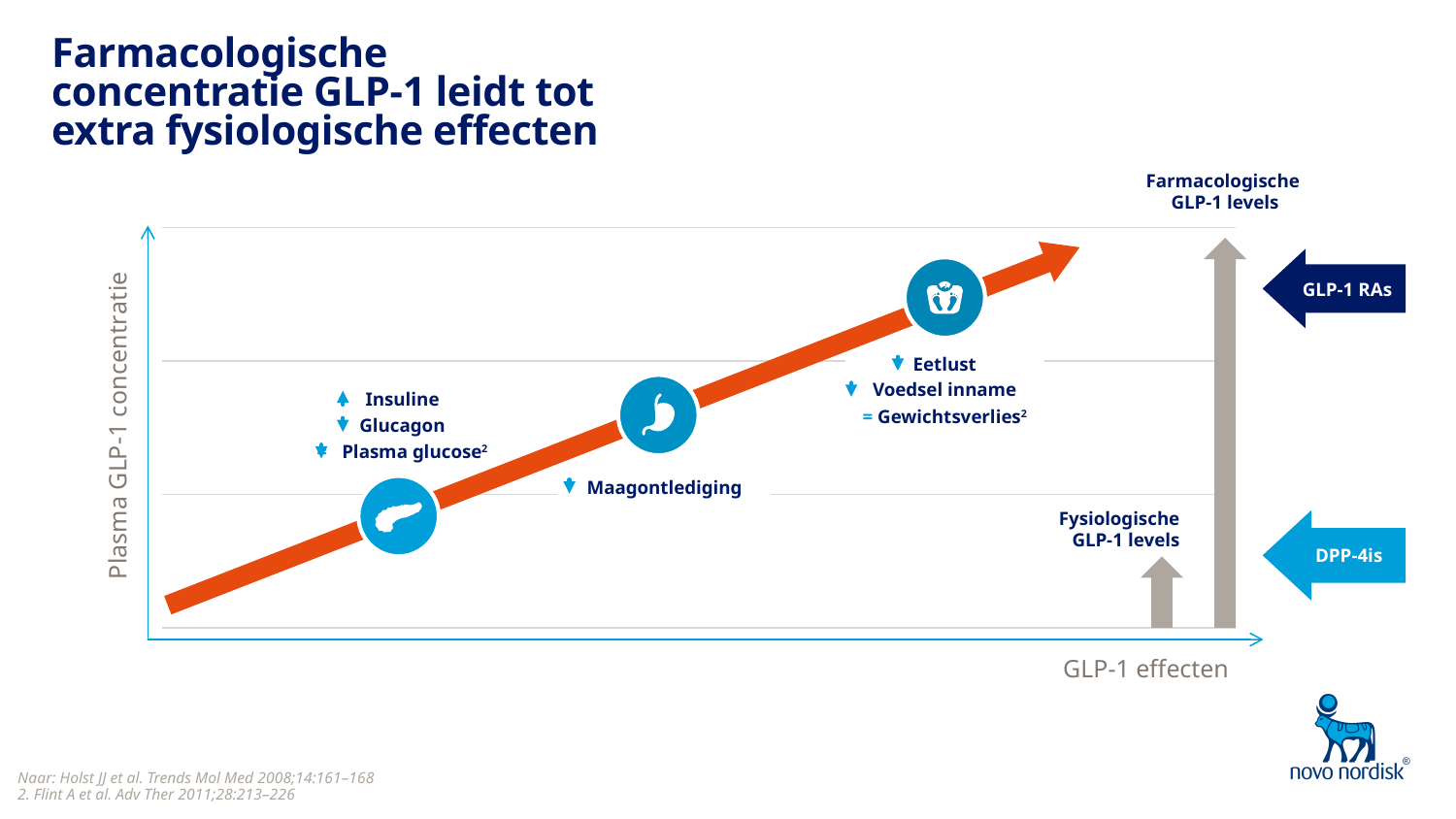
How many circular icon markers are placed along the rising arrow? 3 Which is shown at a higher plasma GLP-1 concentration: Farmacologische GLP-1 levels or Fysiologische GLP-1 levels? Farmacologische GLP-1 levels What is the label of the horizontal axis? GLP-1 effecten What is the label of the vertical axis? Plasma GLP-1 concentratie Does the plasma GLP-1 concentration rise or fall as you move along the x axis (GLP-1 effecten)? rise